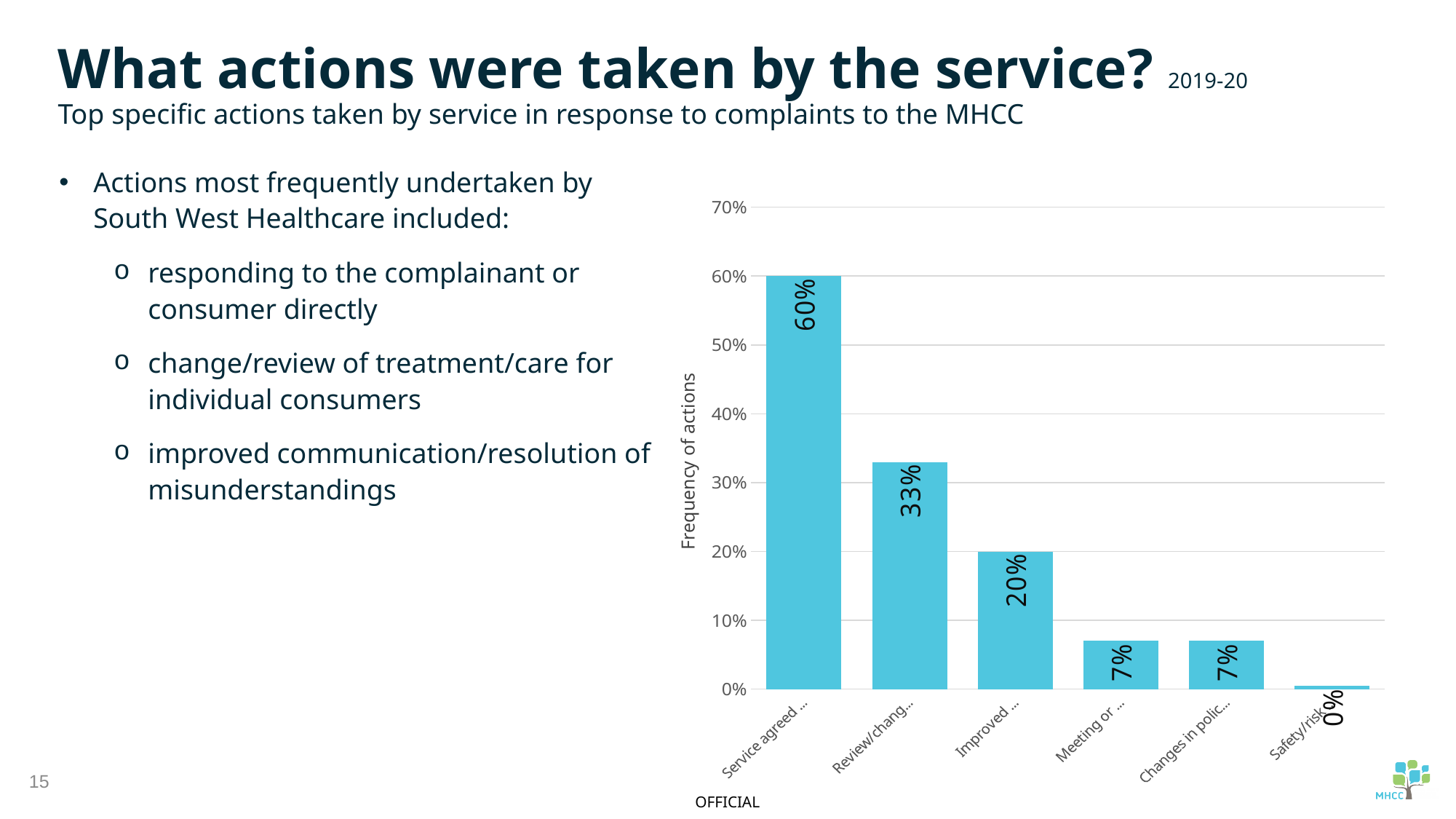
Which category has the lowest value in the chart? Safety/risk... Do the bar values rise or fall from left to right across the chart? fall What is the difference between the values for the categories beginning 'Service agreed' and 'Review/chang'? 27% What is the value of the bar for the category beginning 'Safety/risk'? 0% What is the value of the bar for the category beginning 'Review/chang'? 33% What is the value of the bar for the category beginning 'Service agreed'? 60% How many bars (categories) does the chart show? 6 Which is larger: the value for the category beginning 'Improved' or the category beginning 'Meeting or'? Improved ... Which category has the highest value in the chart? Service agreed ... What kind of chart is shown on the slide? bar chart What is the value of the bar for the category beginning 'Improved'? 20% What is the label of the vertical axis of the chart? Frequency of actions